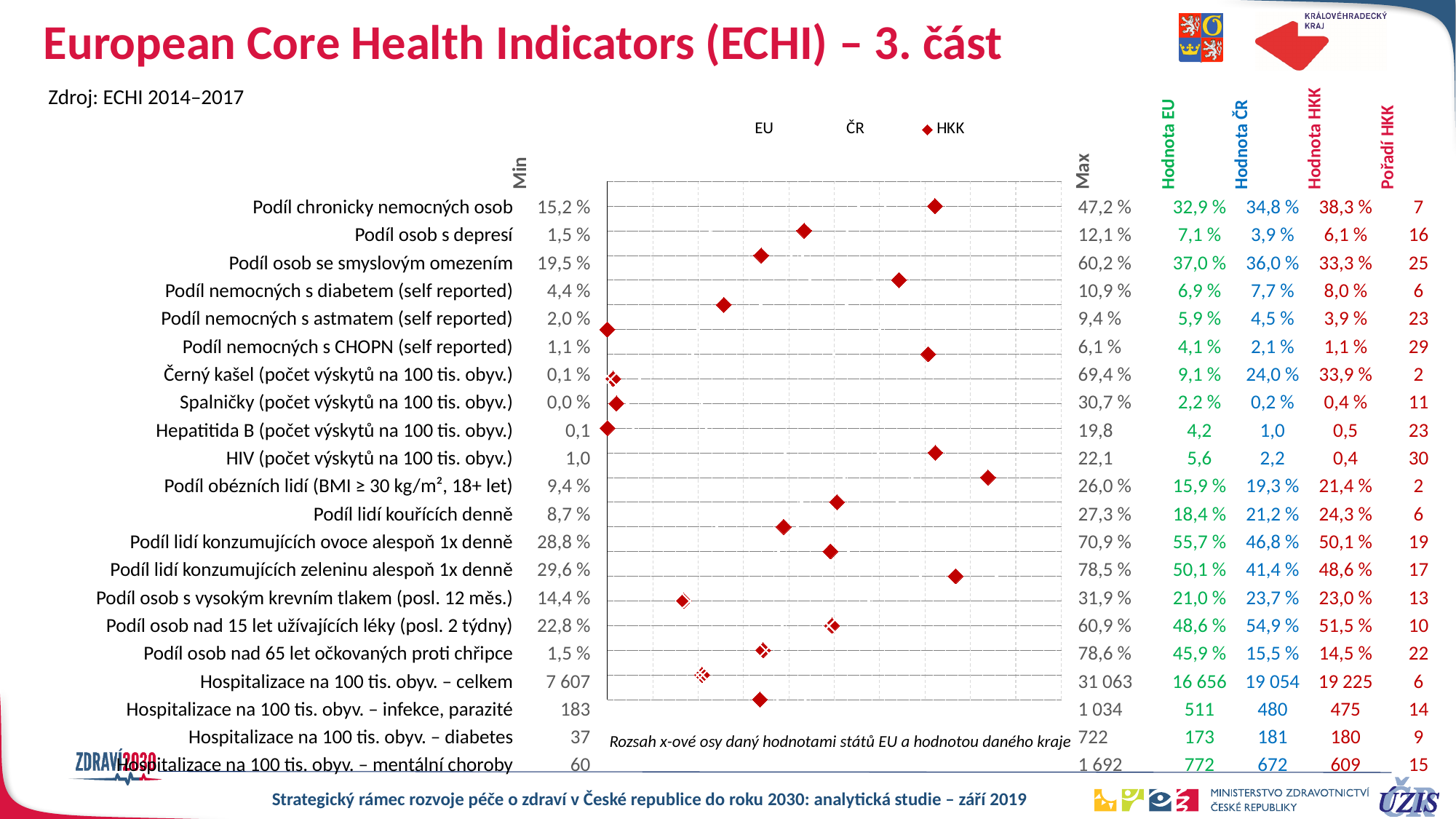
For Podíl obézních lidí (BMI ≥ 30 kg/m², 18+ let), what is the difference between Hodnota HKK and Hodnota EU? 5,5 % How many series does the chart legend list? 3 Which indicator has the highest Pořadí HKK value? HIV (počet výskytů na 100 tis. obyv.) What is the Max value shown for Černý kašel (počet výskytů na 100 tis. obyv.)? 69,4 % What is the Min value shown for Hospitalizace na 100 tis. obyv. – celkem? 7 607 For Podíl lidí kouřících denně, which is larger: Hodnota ČR or Hodnota HKK? Hodnota HKK What kind of chart is shown on the slide? Scatter (dot) chart What are the series names in the chart legend? EU, ČR, HKK What is the Hodnota EU value for Podíl osob s depresí? 7,1 % How many indicators (rows) are plotted in the chart? 21 What is the Hodnota ČR value for Hospitalizace na 100 tis. obyv. – infekce, parazité? 480 What is the Hodnota HKK value for Podíl chronicky nemocných osob? 38,3 %